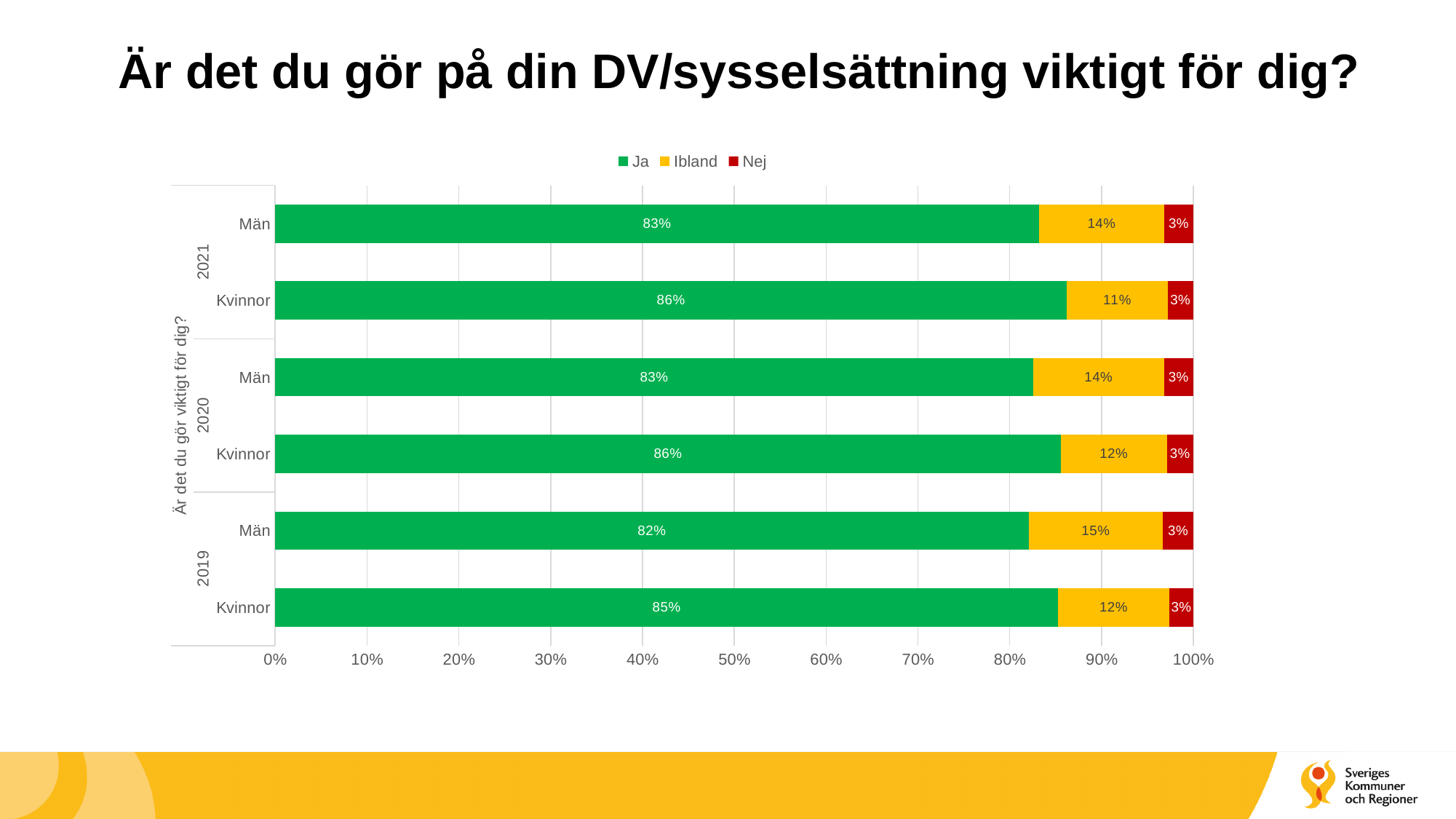
Which colour represents the Nej answer in the chart? Red Which is larger, the Ibland share for Kvinnor in 2021 or for Kvinnor in 2020? Kvinnor 2020 How many series does the legend list? 3 What percentage of Män in 2020 answered Nej? 3% What percentage of Män in 2019 answered Ibland? 15% What kind of chart is shown on the slide? Stacked bar chart Which group has the highest Ibland share? Män 2019 What percentage of Kvinnor in 2019 answered Ja? 85% Which group has the lowest Ja share? Män 2019 What percentage of Kvinnor in 2021 answered Ja? 86% How many bars are shown in the chart? 6 What is the difference between the Ja share for Kvinnor and Män in 2021? 3 percentage points